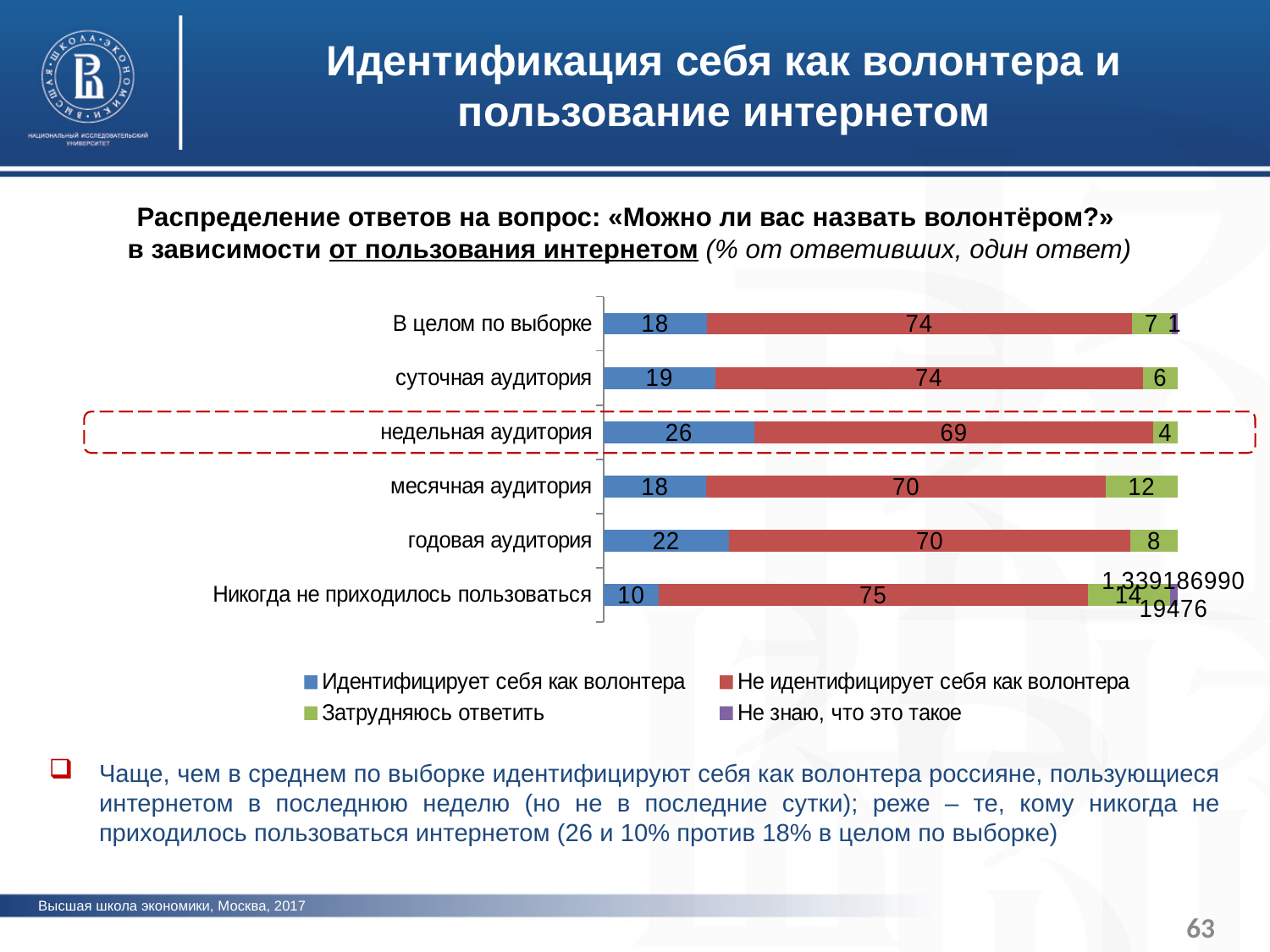
Which category has the lowest value for «Идентифицирует себя как волонтера»? Никогда не приходилось пользоваться What is the value of «Идентифицирует себя как волонтера» for «недельная аудитория»? 26 Which legend entry is shown in red? Не идентифицирует себя как волонтера Which is larger: the «Затрудняюсь ответить» value for «годовая аудитория» or for «суточная аудитория»? годовая аудитория What is the value of «Не идентифицирует себя как волонтера» for «Никогда не приходилось пользоваться»? 75 What is the difference between the «Идентифицирует себя как волонтера» values for «недельная аудитория» and «В целом по выборке»? 8 Which category has the highest value for «Идентифицирует себя как волонтера»? недельная аудитория How many categories (audience groups) are shown on the chart? 6 What is the value of «Затрудняюсь ответить» for «месячная аудитория»? 12 What type of chart is shown on the slide? stacked bar chart How many series does the legend list? 4 What is the value of «Не идентифицирует себя как волонтера» for «В целом по выборке»? 74